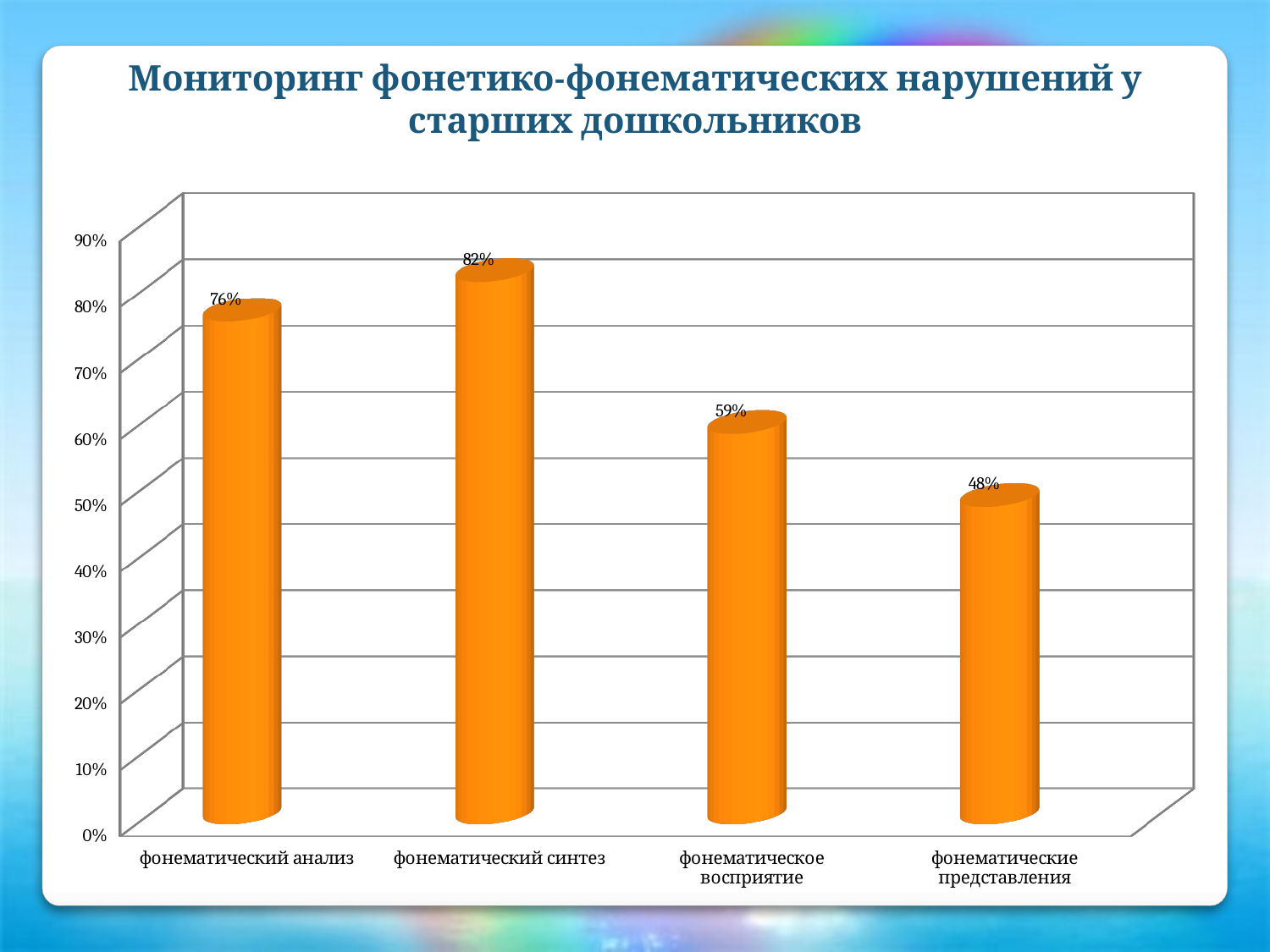
What is the value for фонематический синтез? 82% What is the value for фонематический анализ? 76% What is the value for фонематические представления? 48% Which category has the highest value? фонематический синтез What is the value for фонематическое восприятие? 59% How many categories are shown on the chart? 4 What kind of chart is shown on the slide? bar chart Which is larger, the value for фонематический анализ or the value for фонематическое восприятие? фонематический анализ What is the difference between the values for фонематический синтез and фонематический анализ? 6% What is the title of the slide? Мониторинг фонетико-фонематических нарушений у старших дошкольников Which category has the lowest value? фонематические представления What is the difference between the values for фонематическое восприятие and фонематические представления? 11%